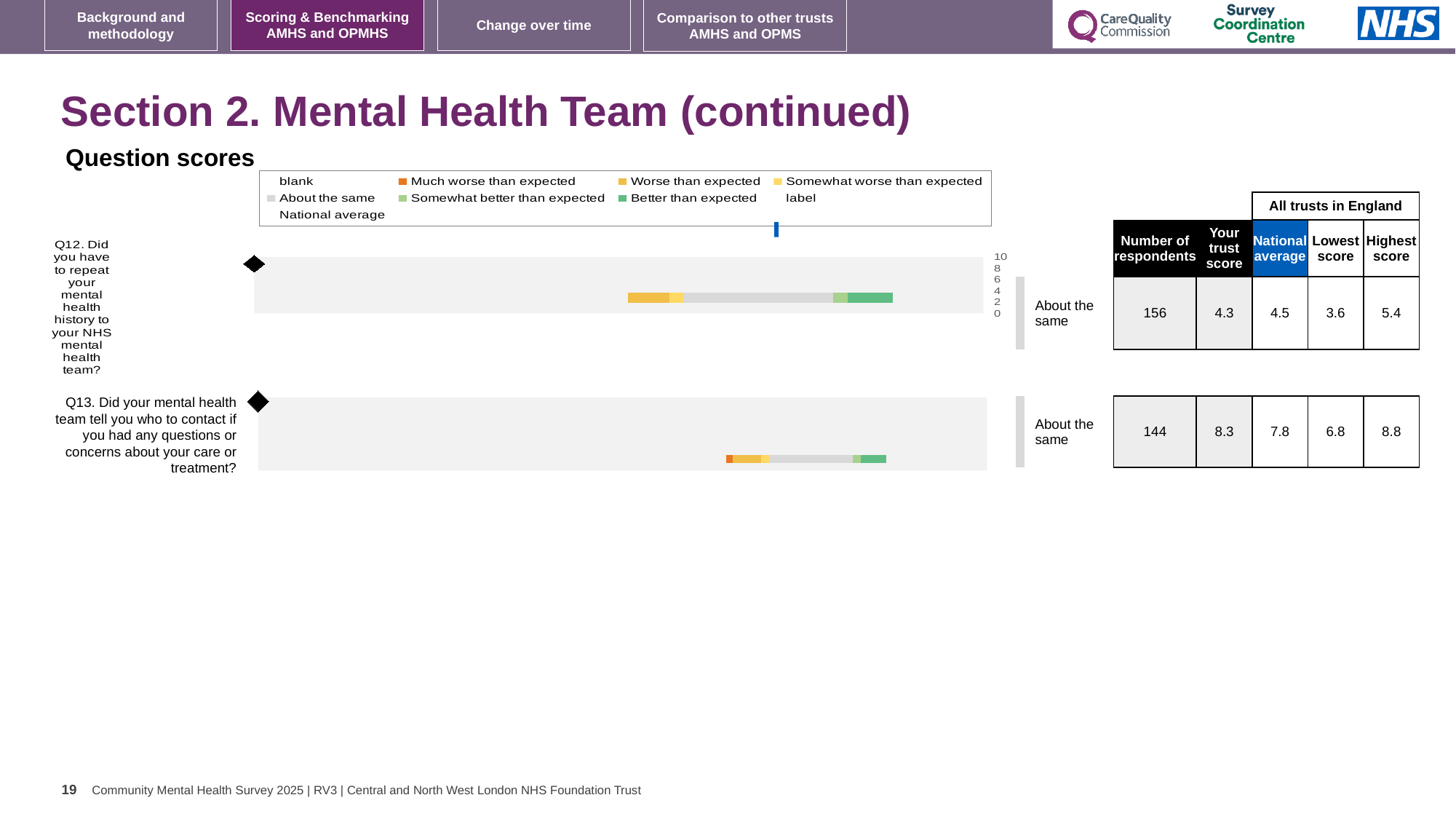
Which question had more respondents, Q12 or Q13? Q12 What is the trust score for Q13 (Did your mental health team tell you who to contact if you had any questions or concerns about your care or treatment?)? 8.3 How many respondents answered Q13? 144 What kind of chart is used to show the question scores? bar chart What is the national average score for Q12? 4.5 What is the trust score for Q12 (Did you have to repeat your mental health history to your NHS mental health team?)? 4.3 What is the highest score among all trusts in England for Q13? 8.8 What is the difference between the highest and lowest scores for Q12? 1.8 By how much does the trust score for Q13 exceed the national average for Q13? 0.5 What is the lowest score among all trusts in England for Q12? 3.6 What benchmark category is shown next to the Q12 chart? About the same How many survey questions are charted on the slide? 2